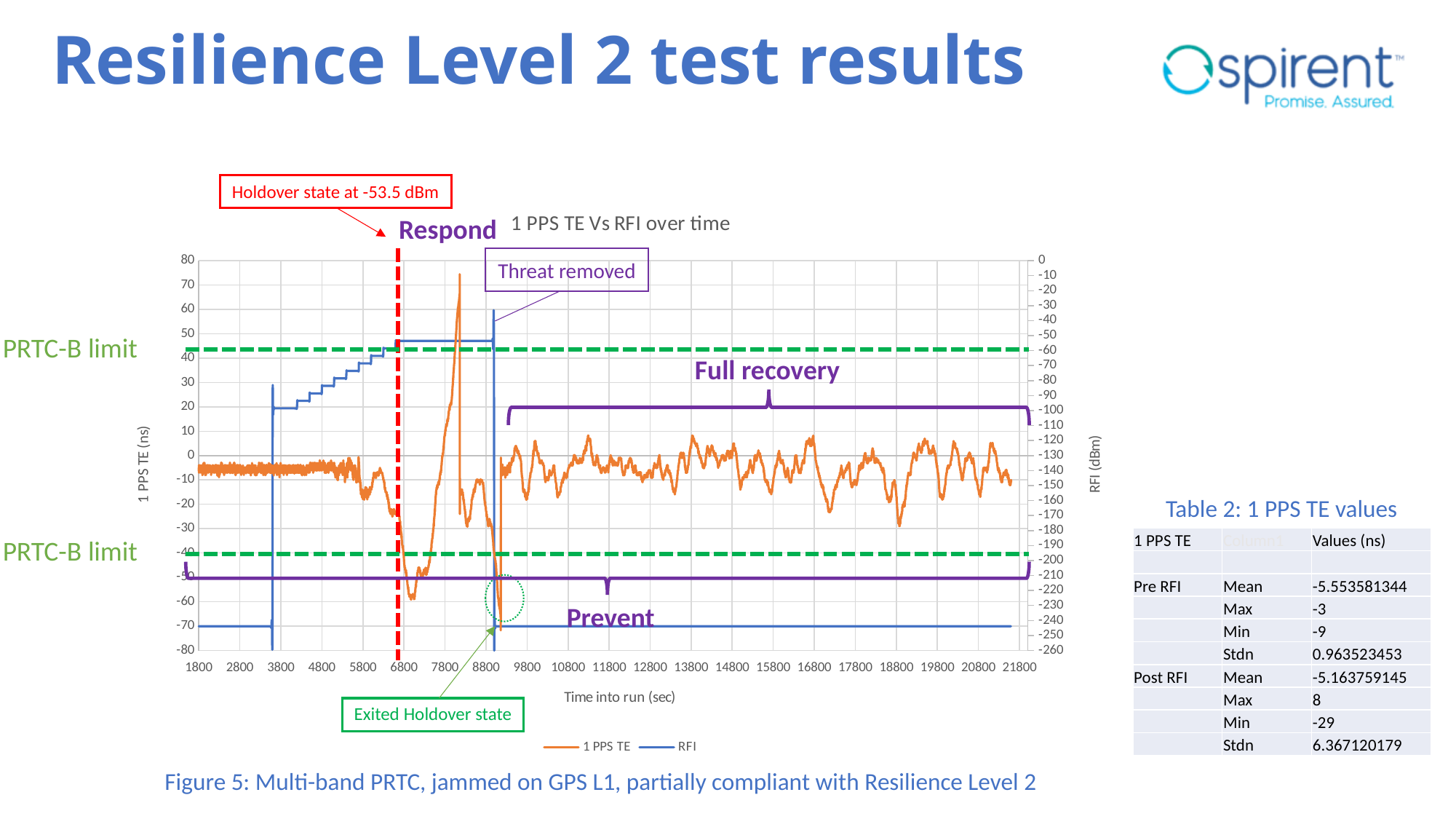
What is the label of the chart's x axis? Time into run (sec) Is the RFI value at 7800 sec greater or less than -100 dBm? greater What kind of chart is shown on the slide? line chart What are the two series named in the chart legend? 1 PPS TE and RFI Is the 1 PPS TE value at 1800 sec greater or less than 0 ns? less Is the peak value of the 1 PPS TE series (around 7800 sec) greater or less than 60 ns? greater How many tick labels are shown on the x axis of the chart? 21 Does the 1 PPS TE series rise or fall between 6800 sec and 7800 sec? rise Which is larger: the 1 PPS TE value at 7800 sec or at 1800 sec? 7800 sec How many series does the chart legend list? 2